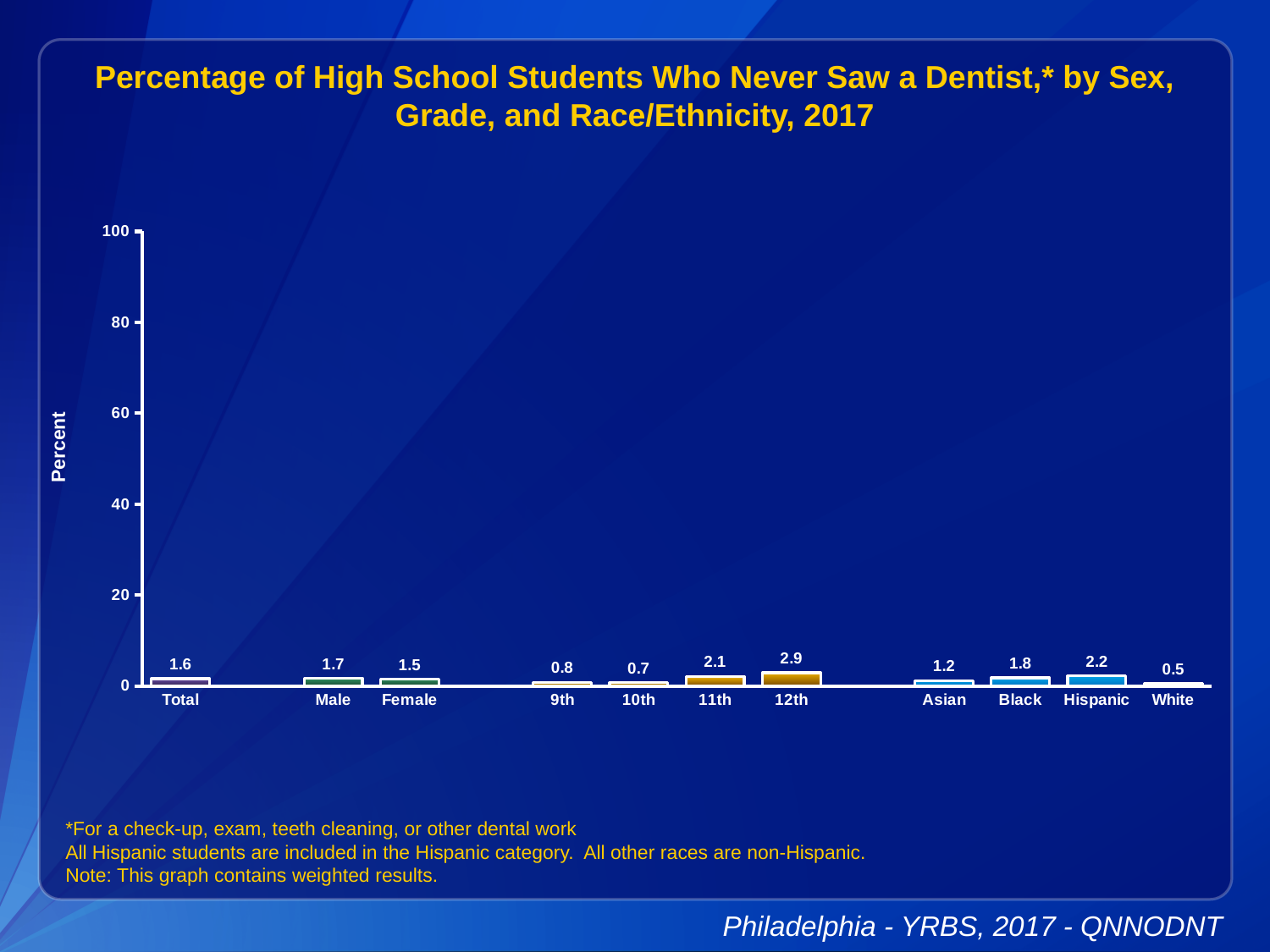
Which category has the highest value? 12th What is the value for Total? 1.6 What is the label of the y axis? Percent What is the value for Hispanic students? 2.2 What is the value for 12th grade students? 2.9 Which category has the lowest value? White How many categories are shown on the x axis? 11 What is the difference between the values for Male and Female? 0.2 What is the value for White students? 0.5 Which is larger, the value for Black or the value for Asian? Black What kind of chart is this? bar chart What is the difference between the values for 12th and 9th grade? 2.1